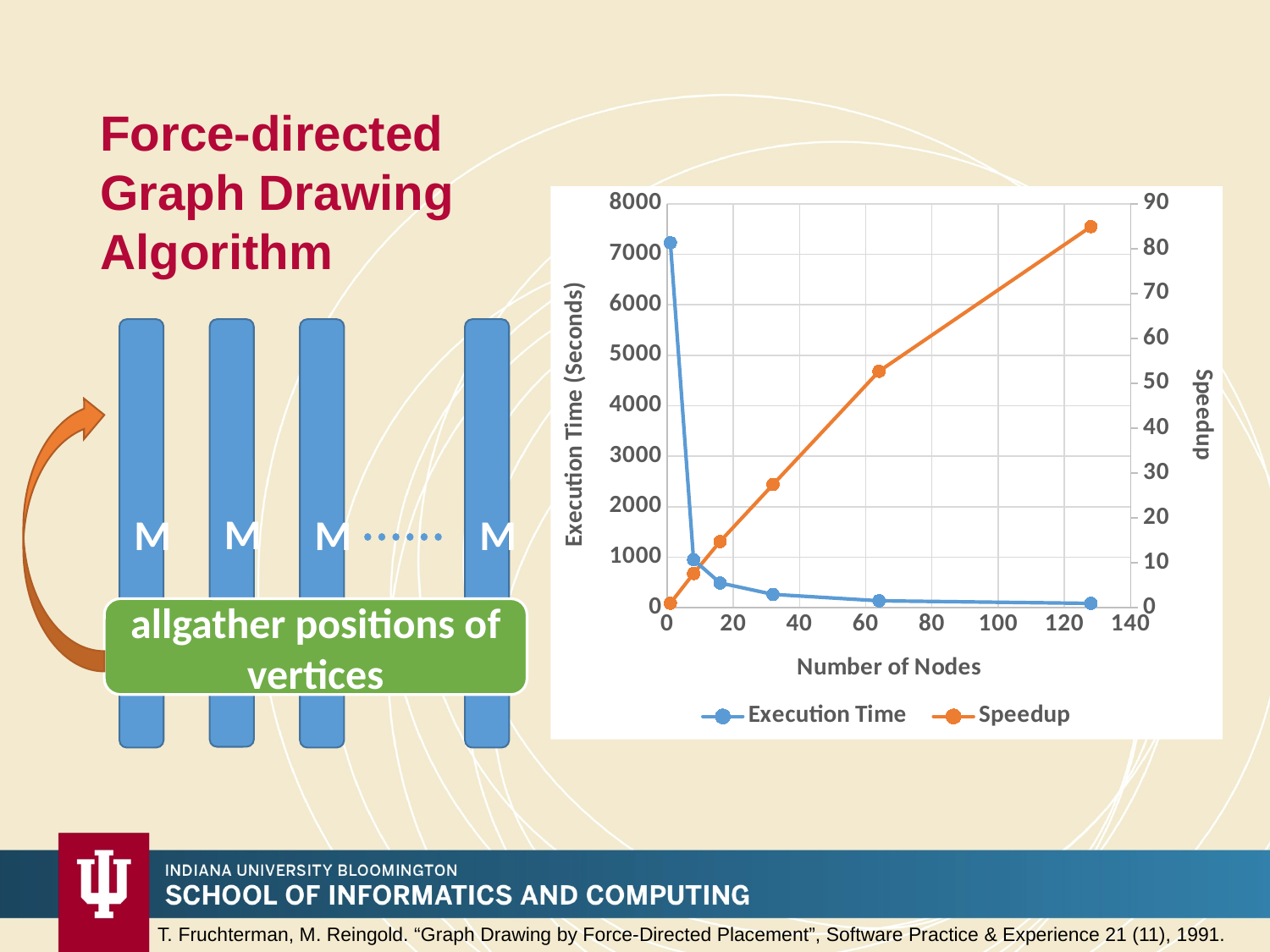
Does the Speedup series rise or fall as the number of nodes increases? rise What is the title of the x axis of the chart? Number of Nodes How many series does the chart legend list? 2 Is the Execution Time value at about 128 nodes greater or less than 1000 seconds? less Is the Speedup value at about 64 nodes greater or less than 40? greater Is the Speedup value at about 32 nodes greater or less than 20? greater How many data points are plotted for the Speedup series? 6 Does the Execution Time series rise or fall as the number of nodes increases? fall What kind of chart is shown on the slide? line chart What are the two series named in the chart legend? Execution Time and Speedup